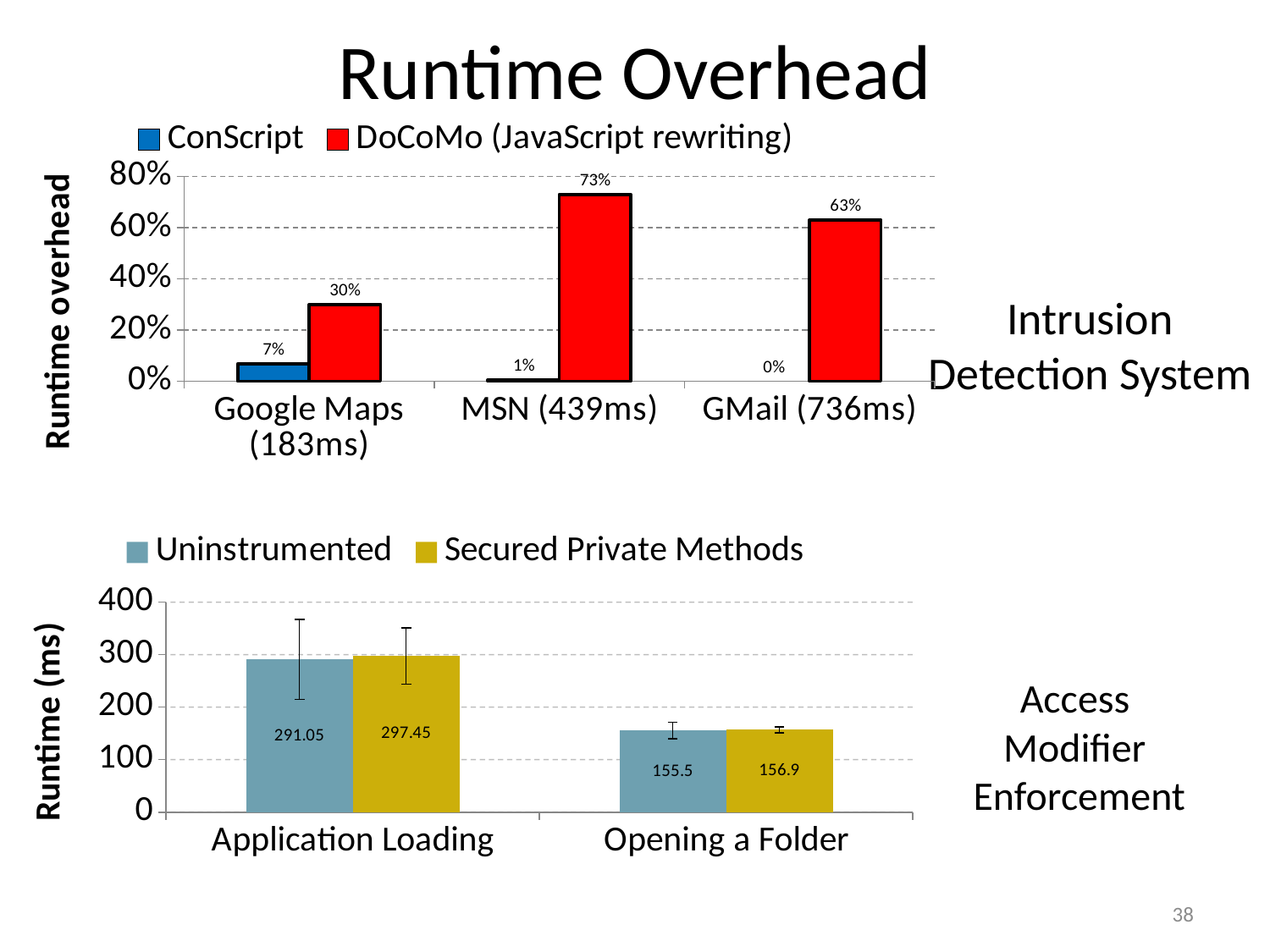
In the bottom chart (Access Modifier Enforcement), what is the Secured Private Methods runtime for Opening a Folder? 156.9 In the bottom chart (Access Modifier Enforcement), how many categories are shown on the x axis? 2 In the top chart (Intrusion Detection System), what is the ConScript runtime overhead for Google Maps (183ms)? 7% In the top chart (Intrusion Detection System), what is the DoCoMo (JavaScript rewriting) runtime overhead for MSN (439ms)? 73% In the bottom chart (Access Modifier Enforcement), what is the difference between the Secured Private Methods and Uninstrumented runtimes for Application Loading? 6.4 In the top chart (Intrusion Detection System), what is the difference between the DoCoMo and ConScript overhead for Google Maps (183ms)? 23% What kind of chart is the bottom chart (Access Modifier Enforcement)? Bar chart In the bottom chart (Access Modifier Enforcement), which is larger for Opening a Folder: Uninstrumented or Secured Private Methods? Secured Private Methods In the top chart (Intrusion Detection System), which application has the lowest ConScript overhead? GMail (736ms) In the top chart (Intrusion Detection System), how many series does the legend list? 2 In the bottom chart (Access Modifier Enforcement), what is the Uninstrumented runtime for Application Loading? 291.05 In the top chart (Intrusion Detection System), which application has the highest DoCoMo (JavaScript rewriting) overhead? MSN (439ms)